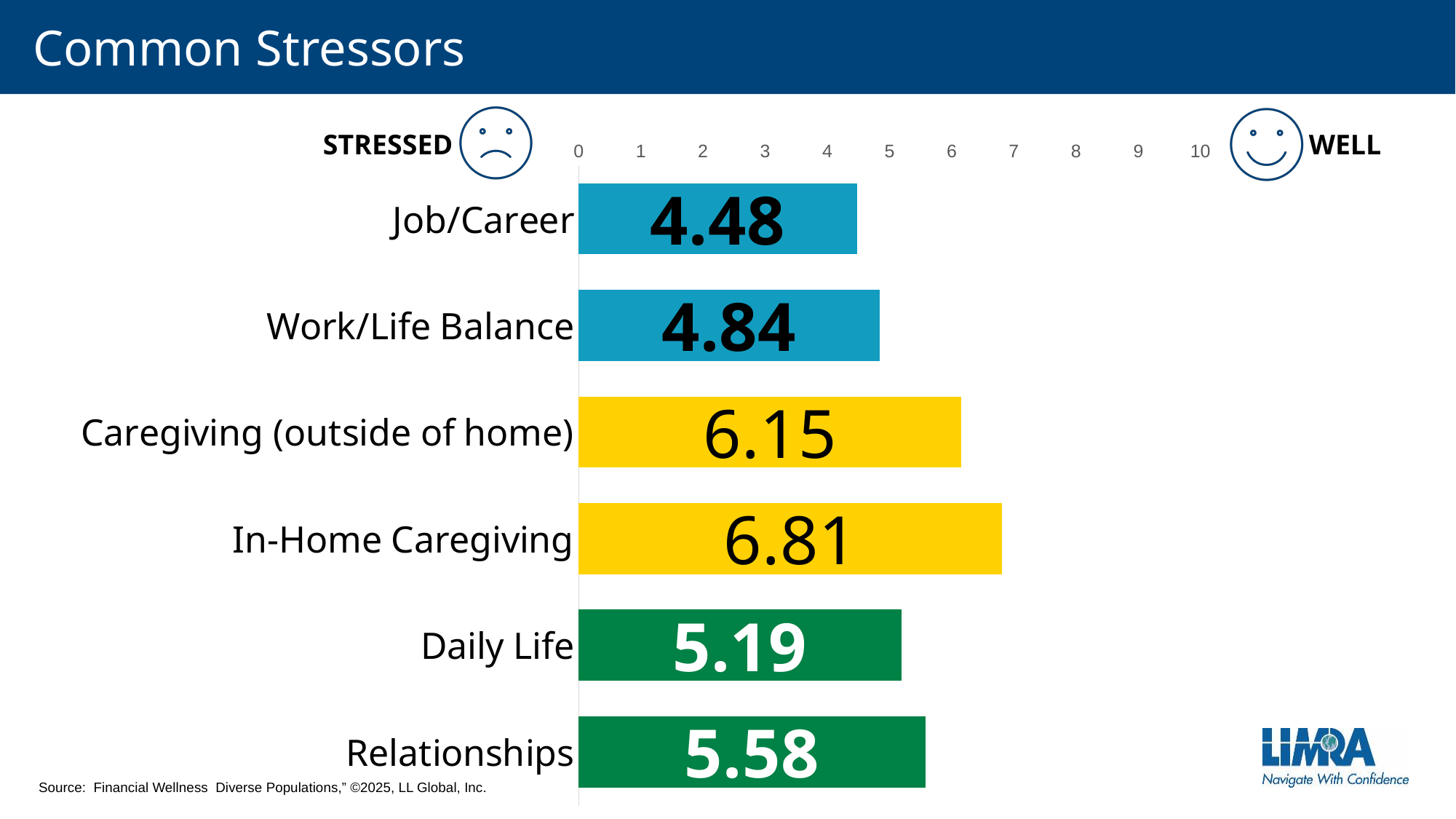
How many categories are shown in the chart? 6 What is the value for In-Home Caregiving? 6.81 Which category has the highest value? In-Home Caregiving What is the difference between the values for Relationships and Daily Life? 0.39 What is the difference between the values for In-Home Caregiving and Job/Career? 2.33 Which is larger, the value for Work/Life Balance or the value for Daily Life? Daily Life Is the value for Caregiving (outside of home) greater or less than 6? greater Which category has the lowest value? Job/Career What is the title of the slide? Common Stressors What is the value for Relationships? 5.58 What is the value for Job/Career? 4.48 What kind of chart is shown on the slide? Bar chart